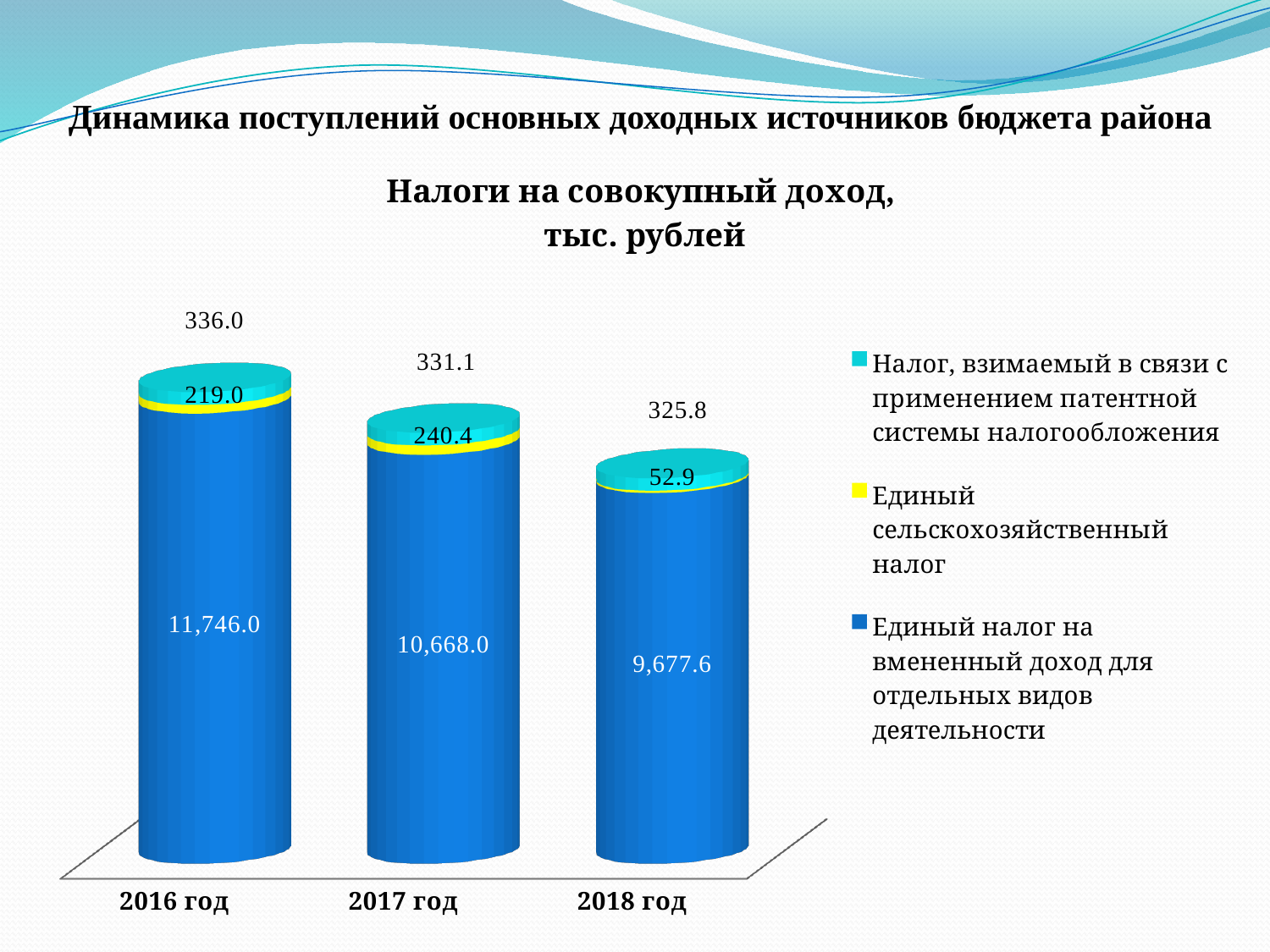
What is the total of the stacked bar for 2018 год? 10,056.3 What is the value of the 'Единый сельскохозяйственный налог' series for 2018 год? 52.9 How many series does the legend list? 3 In which year is the 'Единый налог на вмененный доход для отдельных видов деятельности' value the lowest? 2018 год What is the difference between the 'Единый налог на вмененный доход для отдельных видов деятельности' values for 2016 год and 2017 год? 1,078.0 What is the value of the 'Налог, взимаемый в связи с применением патентной системы налогообложения' series for 2017 год? 331.1 In which year is the 'Единый сельскохозяйственный налог' value the highest? 2017 год What kind of chart is shown on the slide? Stacked bar chart What is the value of the 'Единый налог на вмененный доход для отдельных видов деятельности' series for 2016 год? 11,746.0 How many years (categories) are shown on the x axis? 3 Which is larger: the 'Налог, взимаемый в связи с применением патентной системы налогообложения' value for 2016 год or for 2018 год? 2016 год Does the 'Единый налог на вмененный доход для отдельных видов деятельности' value rise or fall from 2016 год to 2018 год? Fall